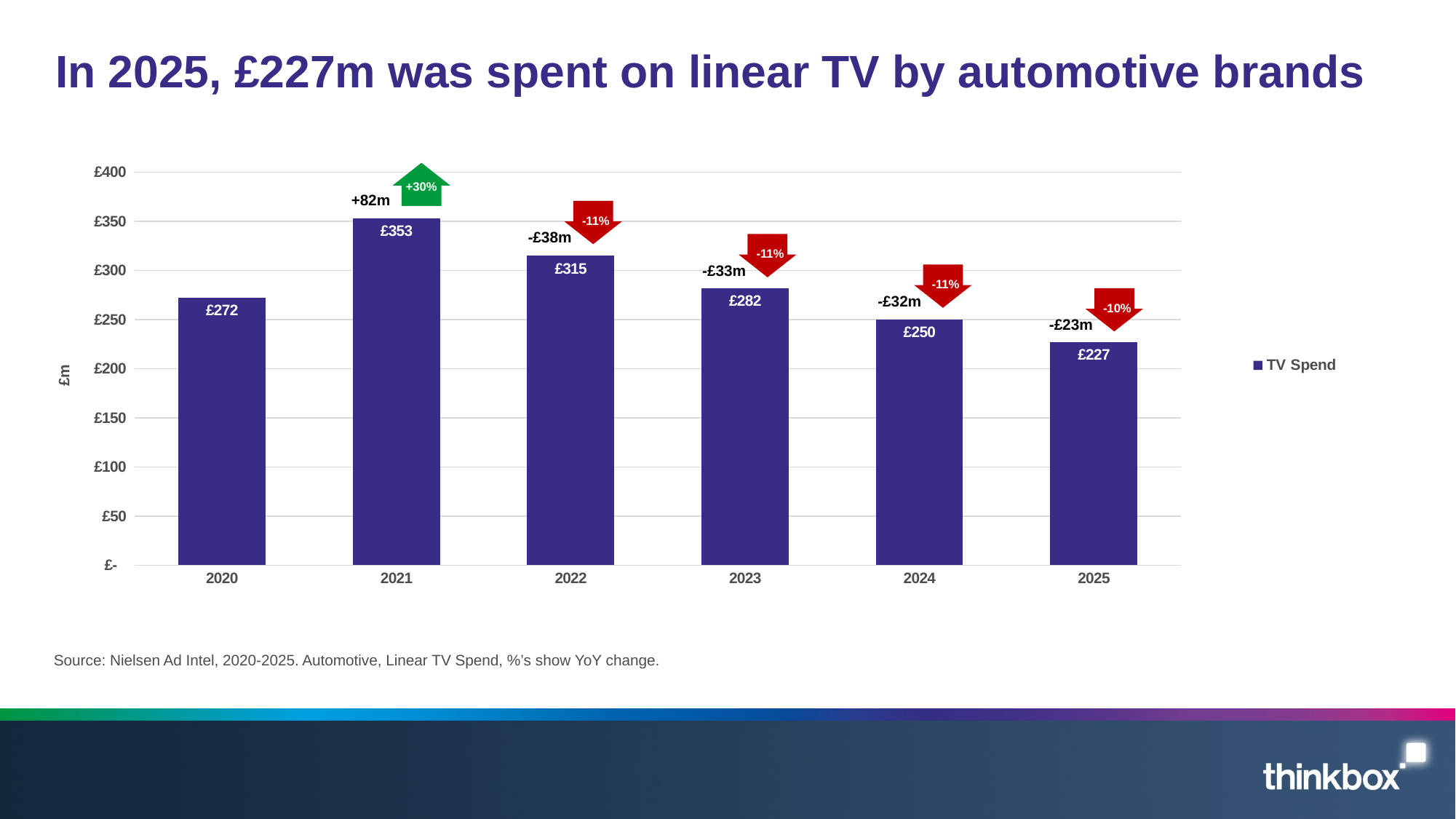
How many years are shown on the x axis of the chart? 6 What year-on-year percentage change is shown above the 2021 bar? +30% Which year had a larger TV Spend, 2022 or 2024? 2022 From 2021 to 2025, do the TV Spend values rise or fall? fall What was the TV Spend value for 2021? £353 How many series does the legend list? 1 What kind of chart is shown on the slide? bar chart What was the TV Spend value for 2023? £282 Is the value for 2024 greater or less than £300? less Which year has the highest TV Spend? 2021 What is the difference between the TV Spend in 2020 and 2025? £45 Which year has the lowest TV Spend? 2025